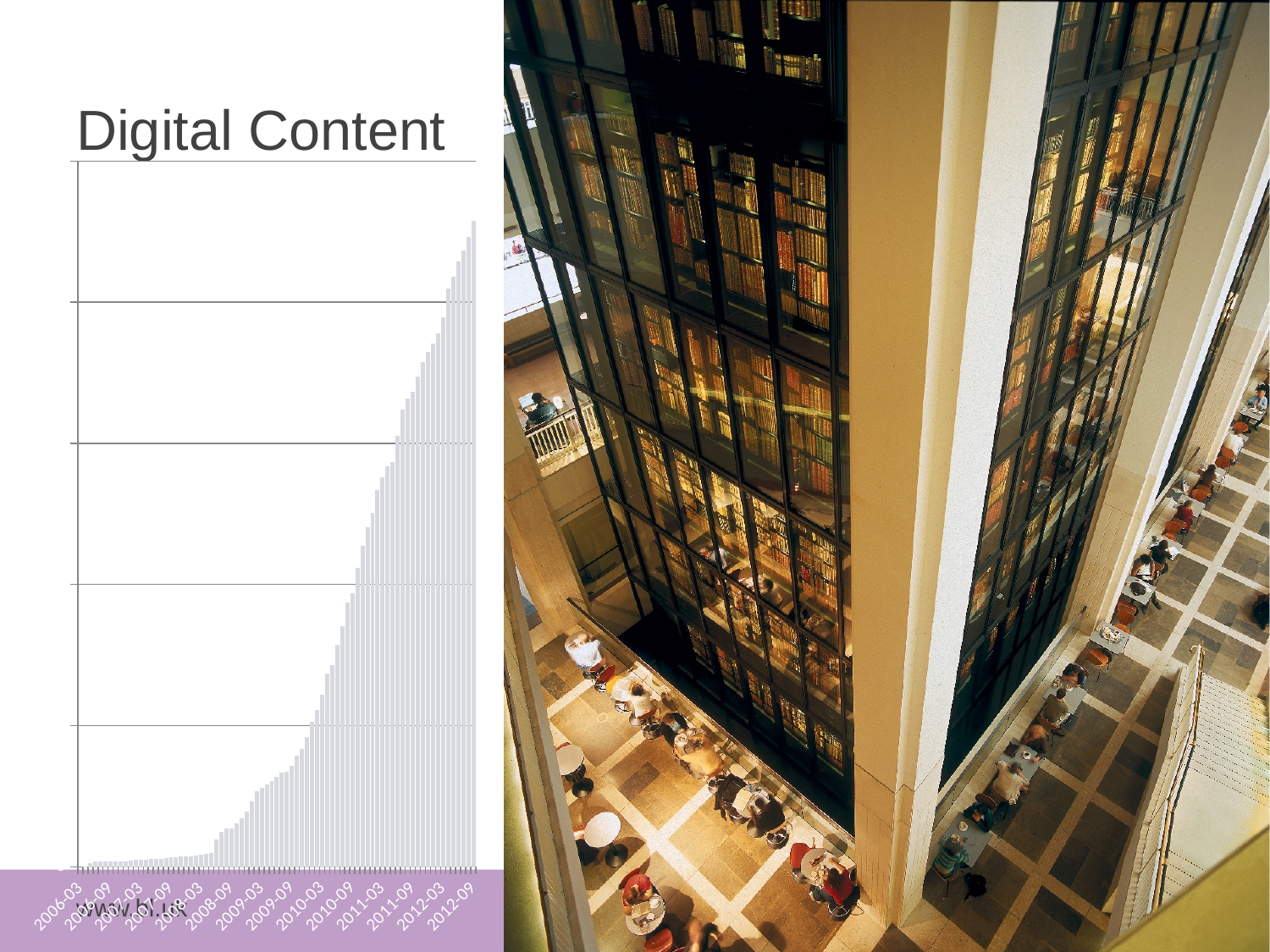
Which is larger, the value at 2011-09 or the value at 2009-09? 2011-09 Which is larger, the value at 2010-03 or the value at 2008-03? 2010-03 What is the first label on the x axis of the chart? 2006-03 Do the values in the chart generally rise or fall from left to right along the x axis? rise Which labelled period on the x axis has the highest bar? 2012-09 What kind of chart is shown on the slide? bar chart Which is larger, the value at 2012-09 or the value at 2006-03? 2012-09 What is the last label on the x axis of the chart? 2012-09 How many labels are shown along the x axis of the chart? 14